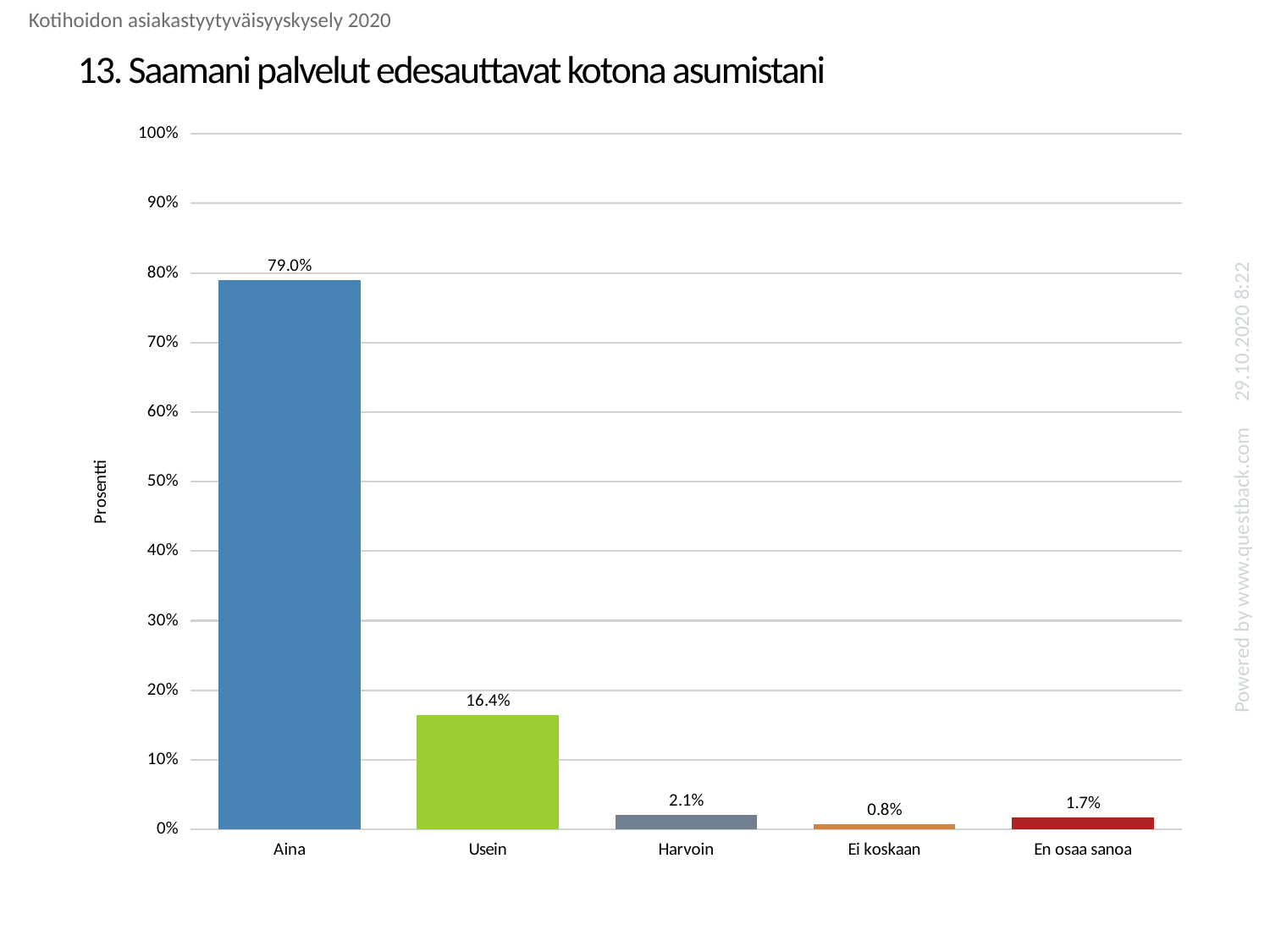
Which is larger, the value for Harvoin or the value for En osaa sanoa? Harvoin What is the difference between the values for Aina and Usein? 62.6% How many categories are shown on the x axis? 5 What is the value for Aina? 79.0% What is the value for Harvoin? 2.1% What is the value for Usein? 16.4% What is the value for Ei koskaan? 0.8% Is the value for Usein greater or less than 20%? less What kind of chart is shown on the slide? bar chart Which category has the highest value? Aina Which category has the lowest value? Ei koskaan What is the value for En osaa sanoa? 1.7%